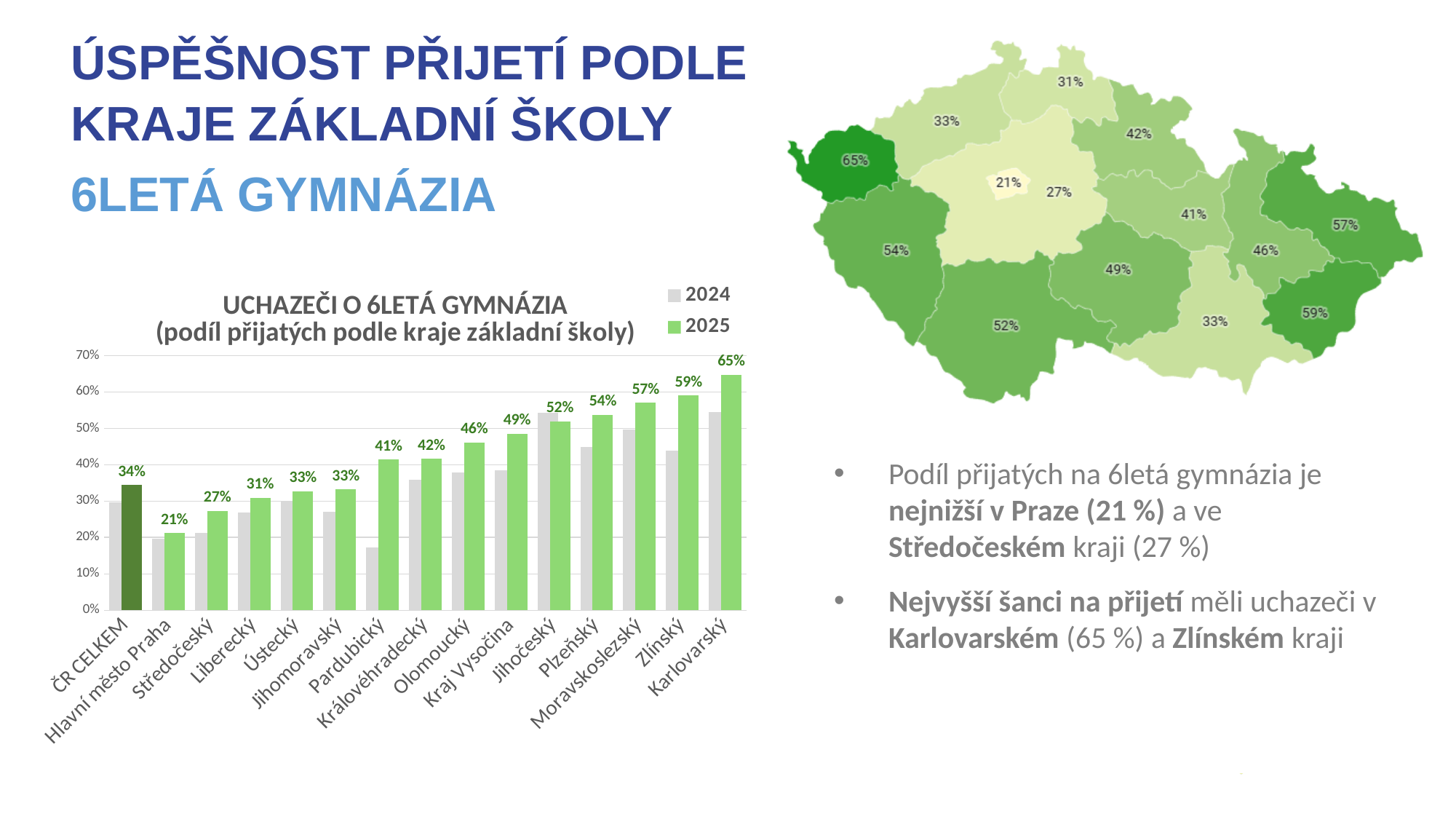
Which has a larger 2025 value in the bar chart, Plzeňský or Jihočeský? Plzeňský How many categories are shown on the x axis of the bar chart? 15 What type of chart is shown on the left of the slide? bar chart What is the 2025 value for Karlovarský in the bar chart? 65% How many series does the legend of the bar chart list? 2 What is the 2025 value for Hlavní město Praha in the bar chart? 21% What is the 2025 value for Olomoucký in the bar chart? 46% Which region has the highest 2025 value in the bar chart? Karlovarský Is the 2024 value for Pardubický in the bar chart greater or less than 20%? less What is the difference between the 2025 values for Karlovarský and Hlavní město Praha? 44% What is the 2025 value for ČR CELKEM in the bar chart? 34% Which region has the lowest 2025 value in the bar chart? Hlavní město Praha